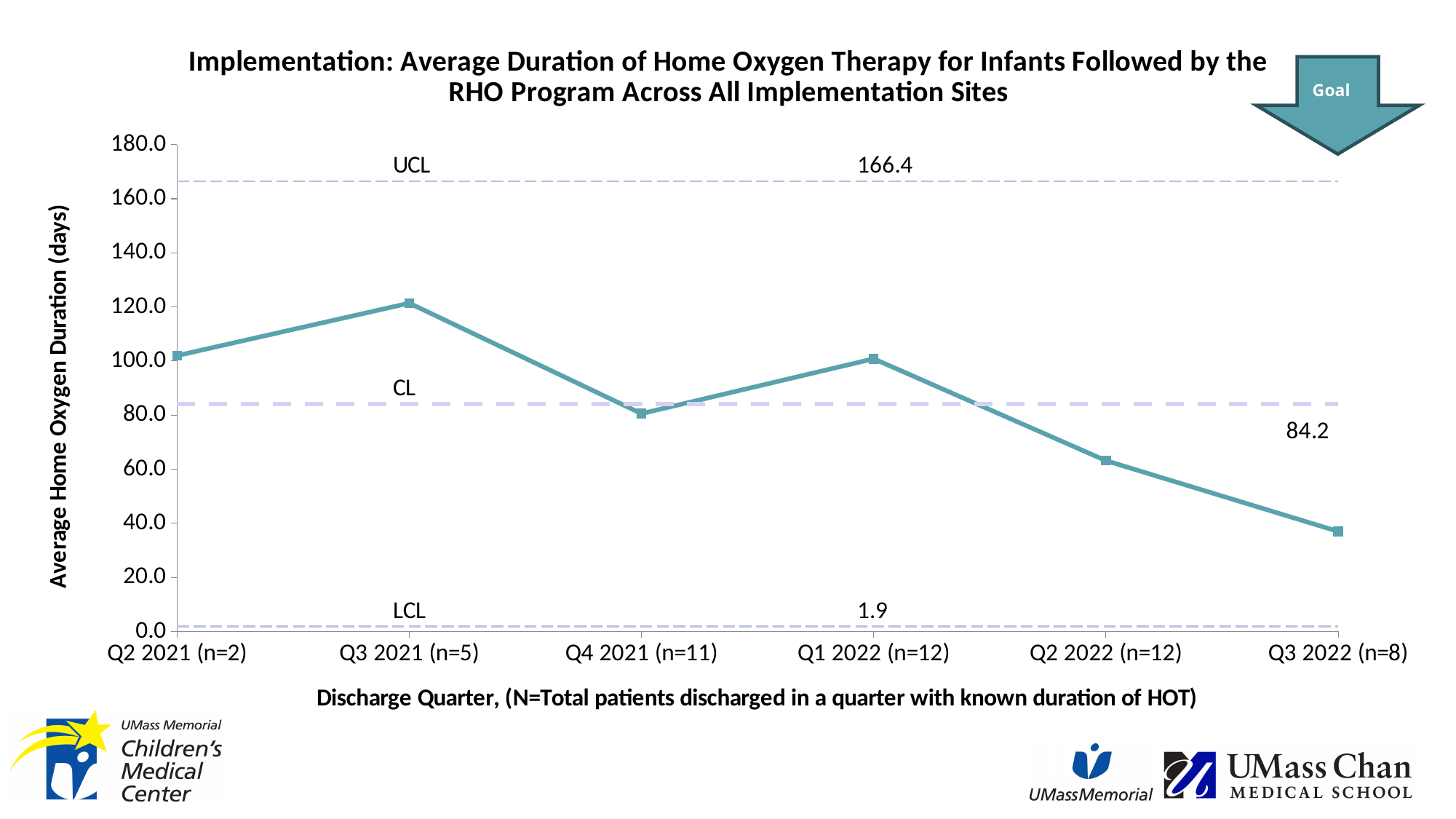
What is the value of the upper control limit (UCL) shown on the chart? 166.4 Does the average home oxygen duration rise or fall from Q1 2022 (n=12) to Q3 2022 (n=8)? fall What is the title of the y axis? Average Home Oxygen Duration (days) Is the average home oxygen duration for Q3 2022 (n=8) greater or less than 60.0 days? less How many discharge quarters are plotted on the x axis? 6 What kind of chart is shown on the slide? line chart Which discharge quarter has the highest average home oxygen duration? Q3 2021 (n=5) Is the average home oxygen duration for Q3 2021 (n=5) greater or less than 100.0 days? greater Which discharge quarter has the lowest average home oxygen duration? Q3 2022 (n=8) Which has a higher average home oxygen duration, Q3 2021 (n=5) or Q2 2022 (n=12)? Q3 2021 (n=5) What is the value of the lower control limit (LCL) shown on the chart? 1.9 What is the value of the center line (CL) shown on the chart? 84.2